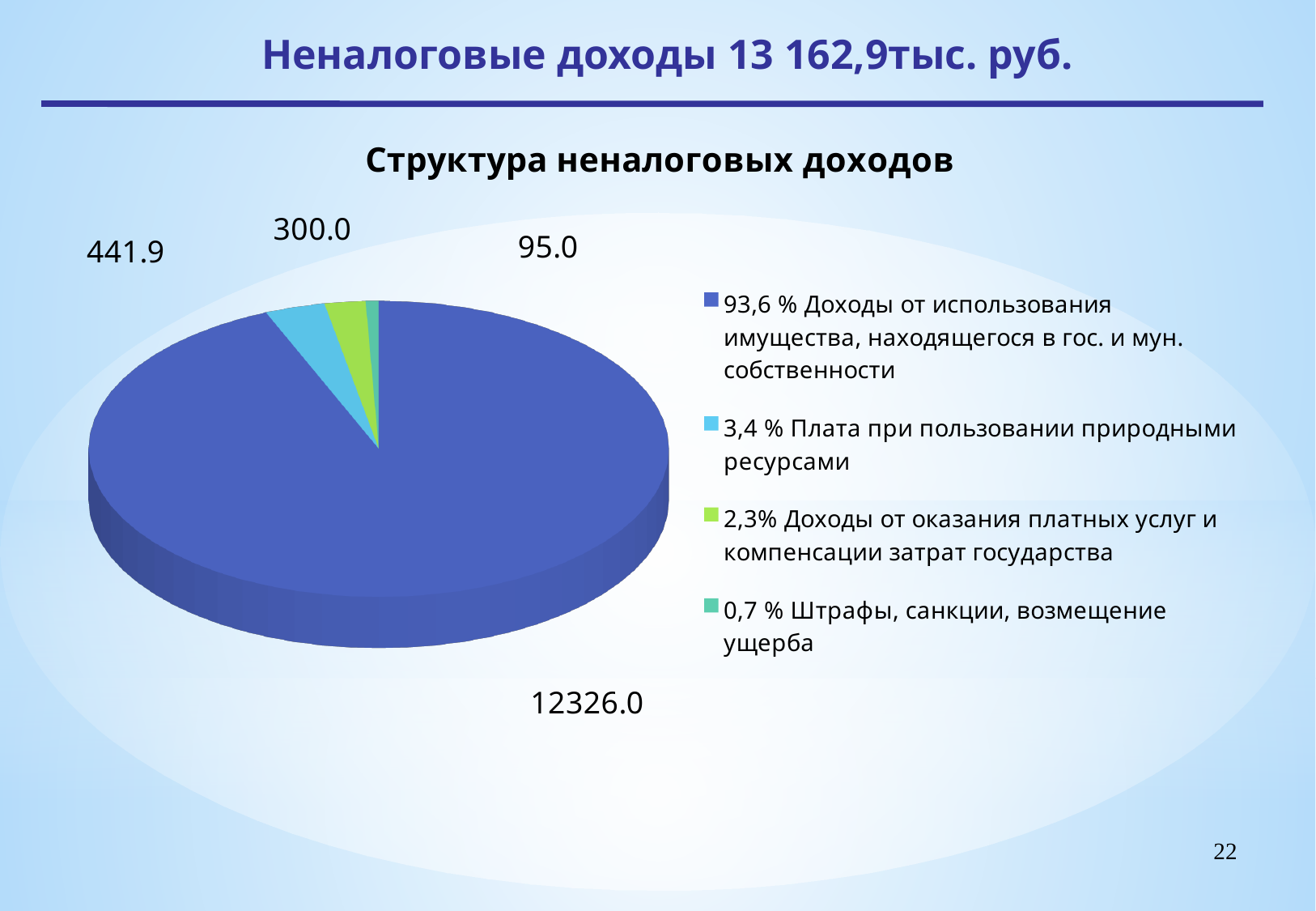
Which category has the largest slice of the pie? Доходы от использования имущества, находящегося в гос. и мун. собственности What share of the pie does Плата при пользовании природными ресурсами represent, according to the legend? 3,4 % What is the title of the chart? Структура неналоговых доходов What is the value of the slice for Доходы от использования имущества, находящегося в гос. и мун. собственности? 12326.0 What is the value of the slice for Доходы от оказания платных услуг и компенсации затрат государства? 300.0 What is the value of the slice for Плата при пользовании природными ресурсами? 441.9 What is the value of the slice for Штрафы, санкции, возмещение ущерба? 95.0 How many slices does the pie chart have? 4 How many entries does the legend list? 4 What is the difference between the values for Плата при пользовании природными ресурсами and Доходы от оказания платных услуг и компенсации затрат государства? 141.9 Which category has the smallest slice of the pie? Штрафы, санкции, возмещение ущерба What type of chart is shown on the slide? pie chart